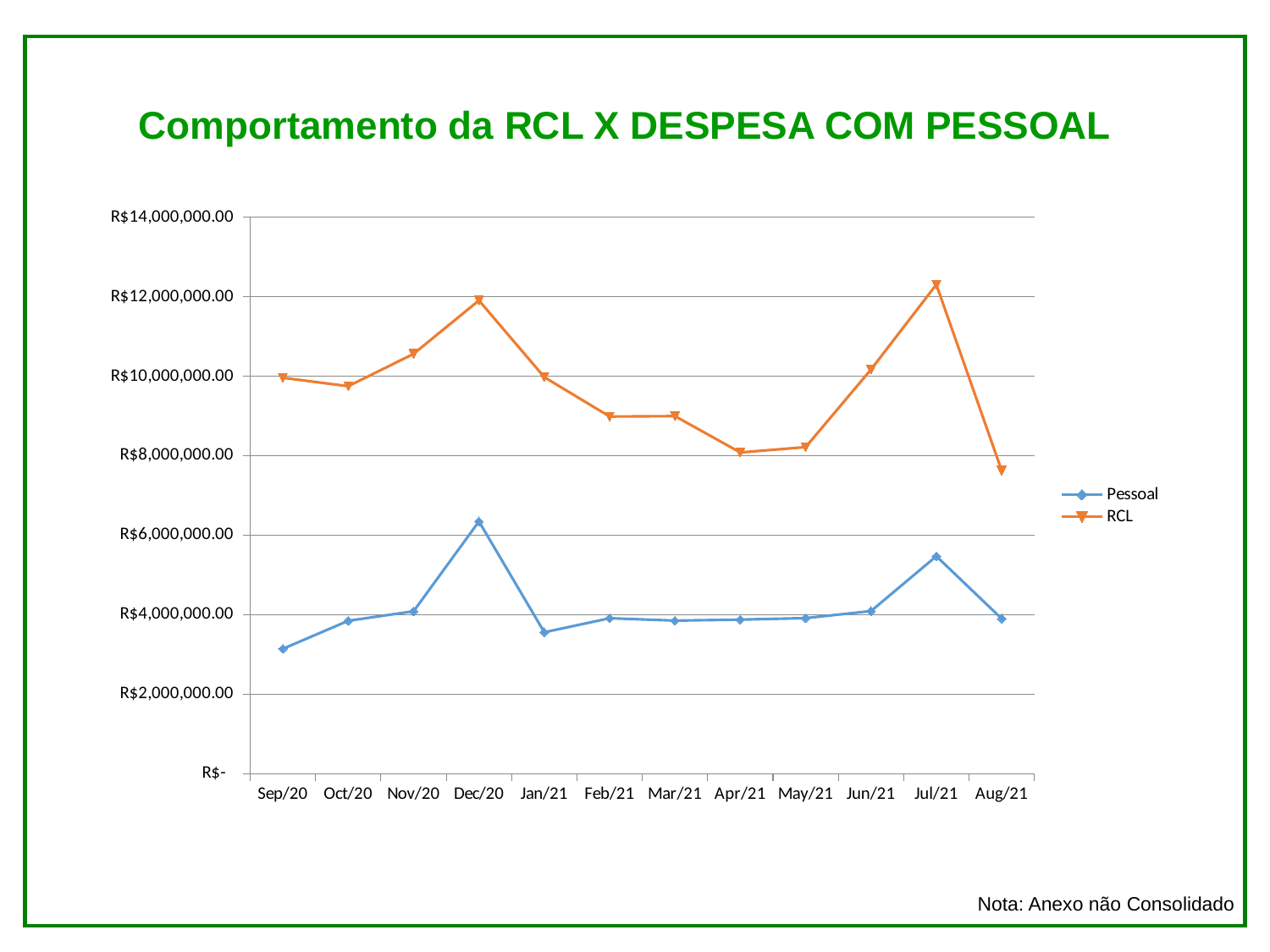
In which month does the RCL series reach its lowest value? Aug/21 In which month does the Pessoal series reach its highest value? Dec/20 In which month does the RCL series reach its highest value? Jul/21 Is the Pessoal value for Jul/21 greater or less than R$4,000,000.00? greater Does the RCL series rise or fall from May/21 to Jul/21? Rise Which is larger for the Pessoal series: the value in Dec/20 or the value in Jul/21? Dec/20 How many months are plotted along the x axis? 12 Is the RCL value for Dec/20 greater or less than R$10,000,000.00? greater What kind of chart is shown on the slide? Line chart How many series does the legend list? 2 In which month does the Pessoal series reach its lowest value? Sep/20 Is the RCL value for Aug/21 greater or less than R$8,000,000.00? less